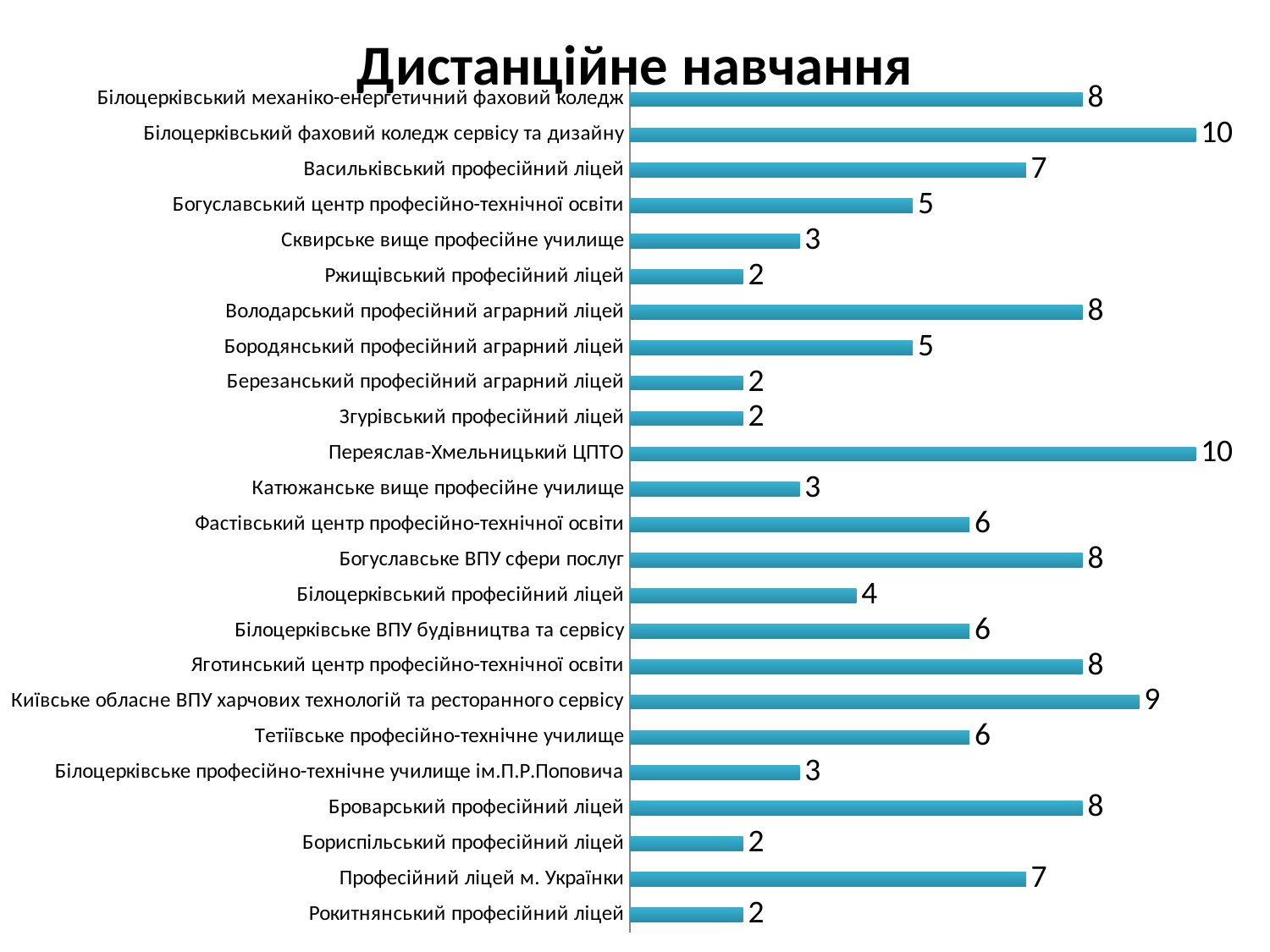
What kind of chart is shown on the slide? Bar chart How many categories are shown in the chart? 24 What is the value for Рокитнянський професійний ліцей? 2 What is the difference between the values for Броварський професійний ліцей and Бориспільський професійний ліцей? 6 Which has a larger value, Богуславський центр професійно-технічної освіти or Яготинський центр професійно-технічної освіти? Яготинський центр професійно-технічної освіти What is the value for Переяслав-Хмельницький ЦПТО? 10 What is the value for Білоцерківський професійний ліцей? 4 What is the value for Васильківський професійний ліцей? 7 Which has a larger value, Фастівський центр професійно-технічної освіти or Катюжанське вище професійне училище? Фастівський центр професійно-технічної освіти What is the value for Київське обласне ВПУ харчових технологій та ресторанного сервісу? 9 What is the title of the chart? Дистанційне навчання What is the difference between the values for Білоцерківський фаховий коледж сервісу та дизайну and Ржищівський професійний ліцей? 8